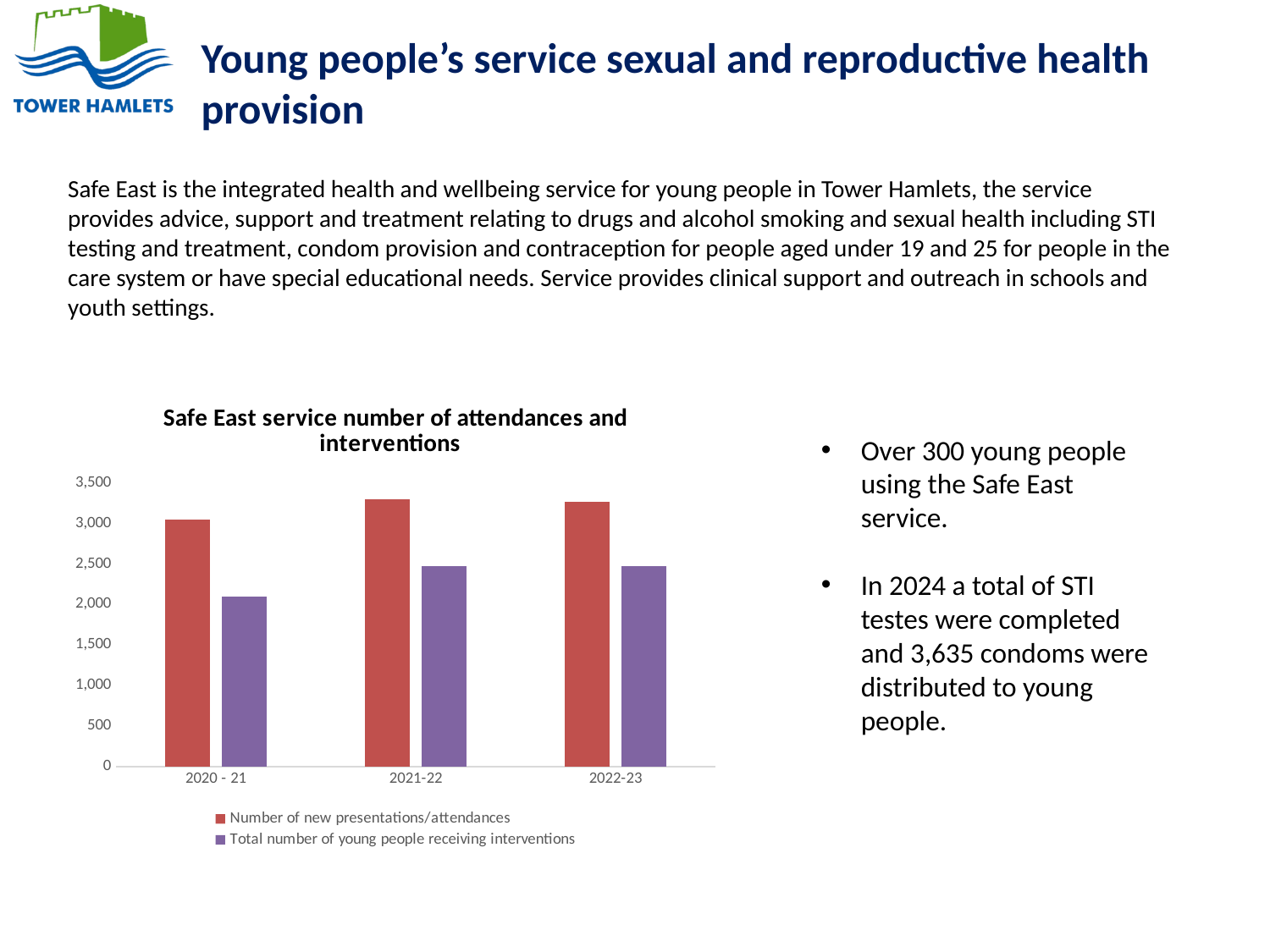
How many series does the chart legend list? 2 In which year is the total number of young people receiving interventions lowest? 2020 - 21 Is the total number of young people receiving interventions for 2022-23 greater or less than 2,000? greater Is the number of new presentations/attendances for 2022-23 greater or less than 3,000? greater Is the total number of young people receiving interventions for 2020 - 21 greater or less than 2,500? less Which series is shown in purple in the chart? Total number of young people receiving interventions How many year categories are shown on the x axis of the chart? 3 For 2020 - 21, which is larger: the number of new presentations/attendances or the total number of young people receiving interventions? Number of new presentations/attendances What kind of chart is shown on the slide? Bar chart In which year is the number of new presentations/attendances lowest? 2020 - 21 What is the title of the chart? Safe East service number of attendances and interventions